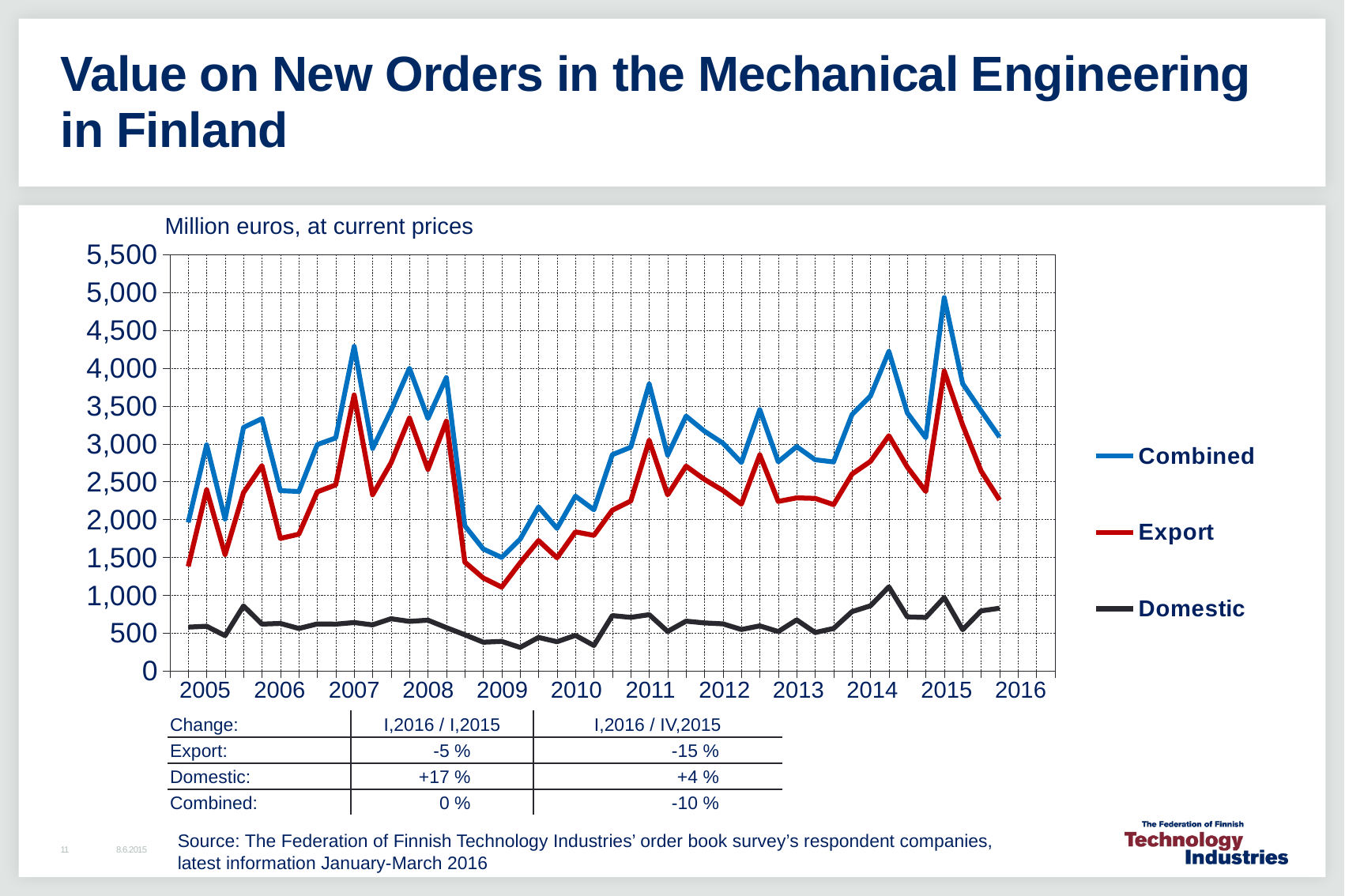
What kind of chart is shown on the slide? Line chart Does the Combined series rise or fall from its 2015 peak to 2016? fall Is the peak value of the Combined series in 2007 greater or less than 4,000? greater Is the lowest value of the Export series in 2009 greater or less than 1,500? less Which series has the highest values throughout the chart? Combined Is the peak value of the Combined series in 2015 greater or less than 4,500? greater Which series are listed in the chart legend? Combined, Export, Domestic How many series does the legend list? 3 What unit label is shown above the chart? Million euros, at current prices Which series has the lowest values throughout the chart? Domestic Which series is larger in 2010, Export or Domestic? Export